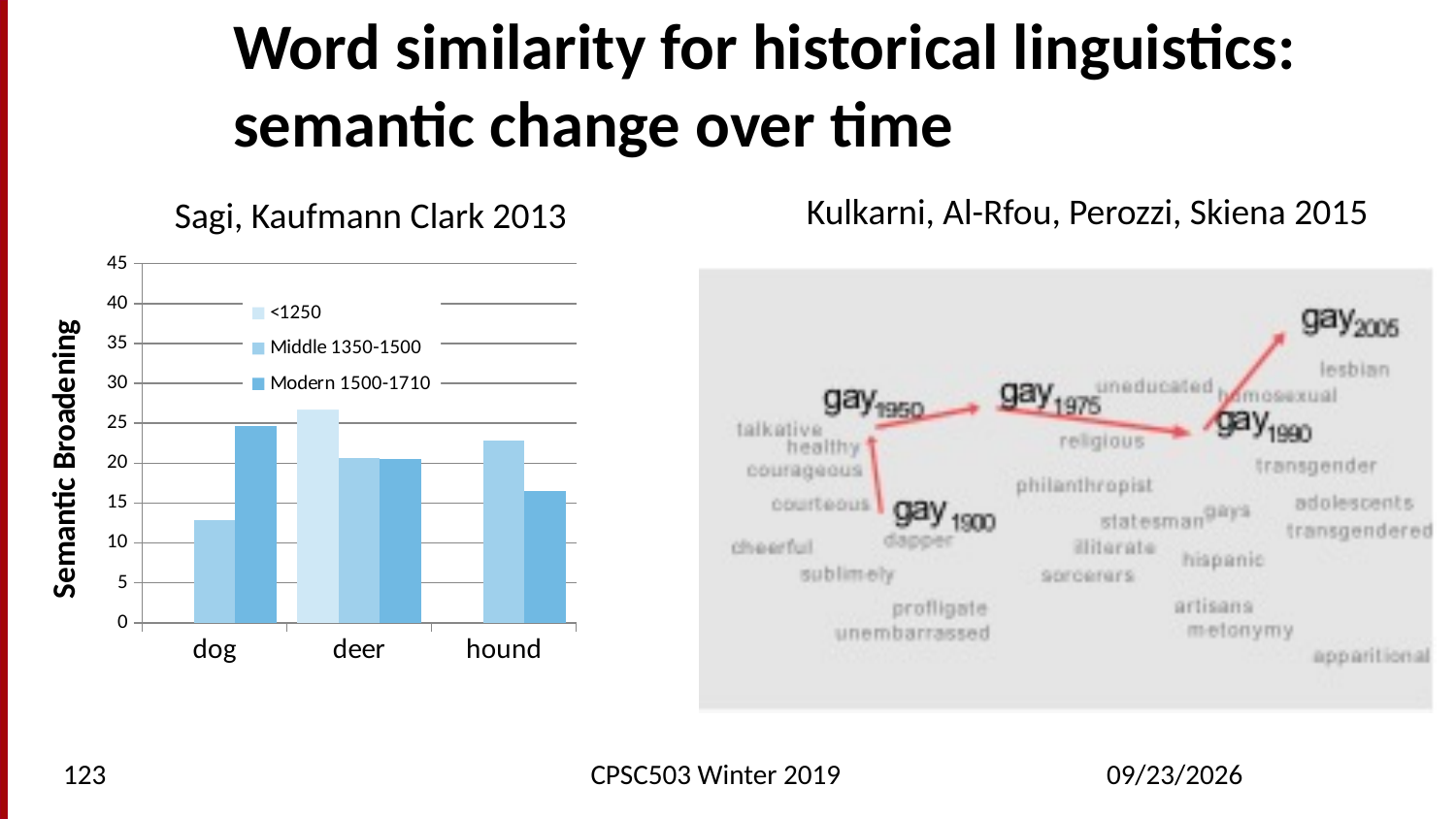
In the bar chart on the left, for dog, which is larger: the Middle 1350-1500 value or the Modern 1500-1710 value? Modern 1500-1710 In the bar chart on the left, is the Modern 1500-1710 value for hound greater or less than 20? less In the bar chart on the left, how many word categories are shown on the x axis? 3 In the bar chart on the left, which series does the lightest blue colour represent? <1250 In the bar chart on the left, which word has the highest Modern 1500-1710 value? dog In the bar chart on the left, is the <1250 value for deer greater or less than 25? greater In the bar chart on the left, is the Modern 1500-1710 value for dog greater or less than 20? greater In the bar chart on the left, for hound, which is larger: the Middle 1350-1500 value or the Modern 1500-1710 value? Middle 1350-1500 What kind of chart is shown on the left of the slide, under "Sagi, Kaufmann Clark 2013"? bar chart In the bar chart on the left, how many series does the legend list? 3 In the bar chart on the left, what is the label of the y axis? Semantic Broadening